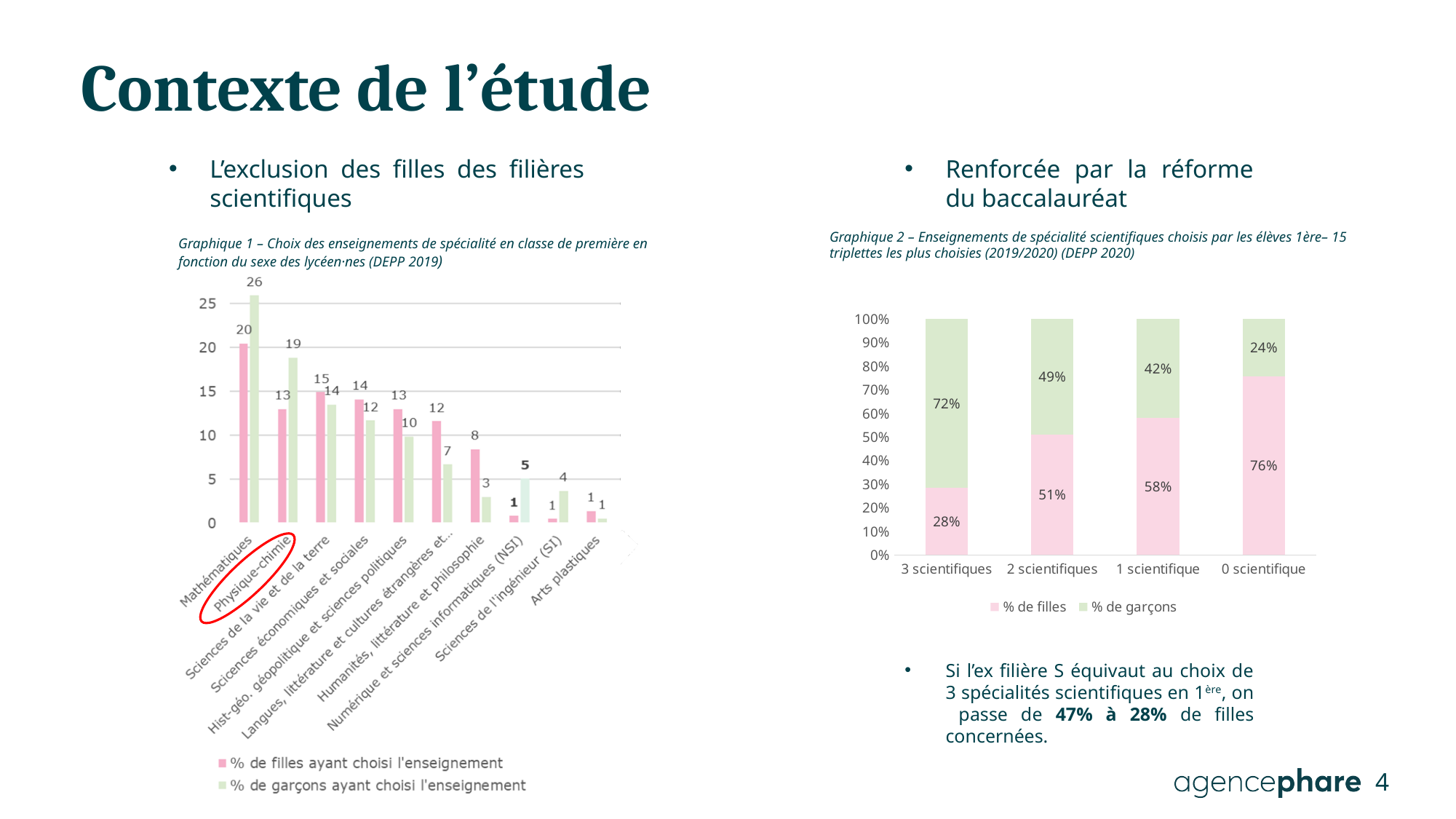
In Graphique 2 (right chart), what is the difference between the % de garçons and the % de filles for '3 scientifiques'? 44% In Graphique 2 (right chart), how many series does the legend list? 2 In Graphique 1 (left chart), what is the difference between the % de garçons and the % de filles for Physique-chimie? 6 In Graphique 1 (left chart), what is the % de garçons ayant choisi l'enseignement for Mathématiques? 26 In Graphique 2 (right chart), which category has the highest % de filles? 0 scientifique In Graphique 2 (right chart), which category has the lowest % de garçons? 0 scientifique In Graphique 1 (left chart), what is the % de filles ayant choisi l'enseignement for Physique-chimie? 13 In Graphique 1 (left chart), how many categories are shown on the x axis? 10 In Graphique 1 (left chart), which is larger for Numérique et sciences informatiques (NSI): the % de filles or the % de garçons? % de garçons In Graphique 2 (right chart), what is the % de filles for '3 scientifiques'? 28% In Graphique 2 (right chart), what kind of chart is shown? Stacked bar chart In Graphique 2 (right chart), what is the % de garçons for '0 scientifique'? 24%